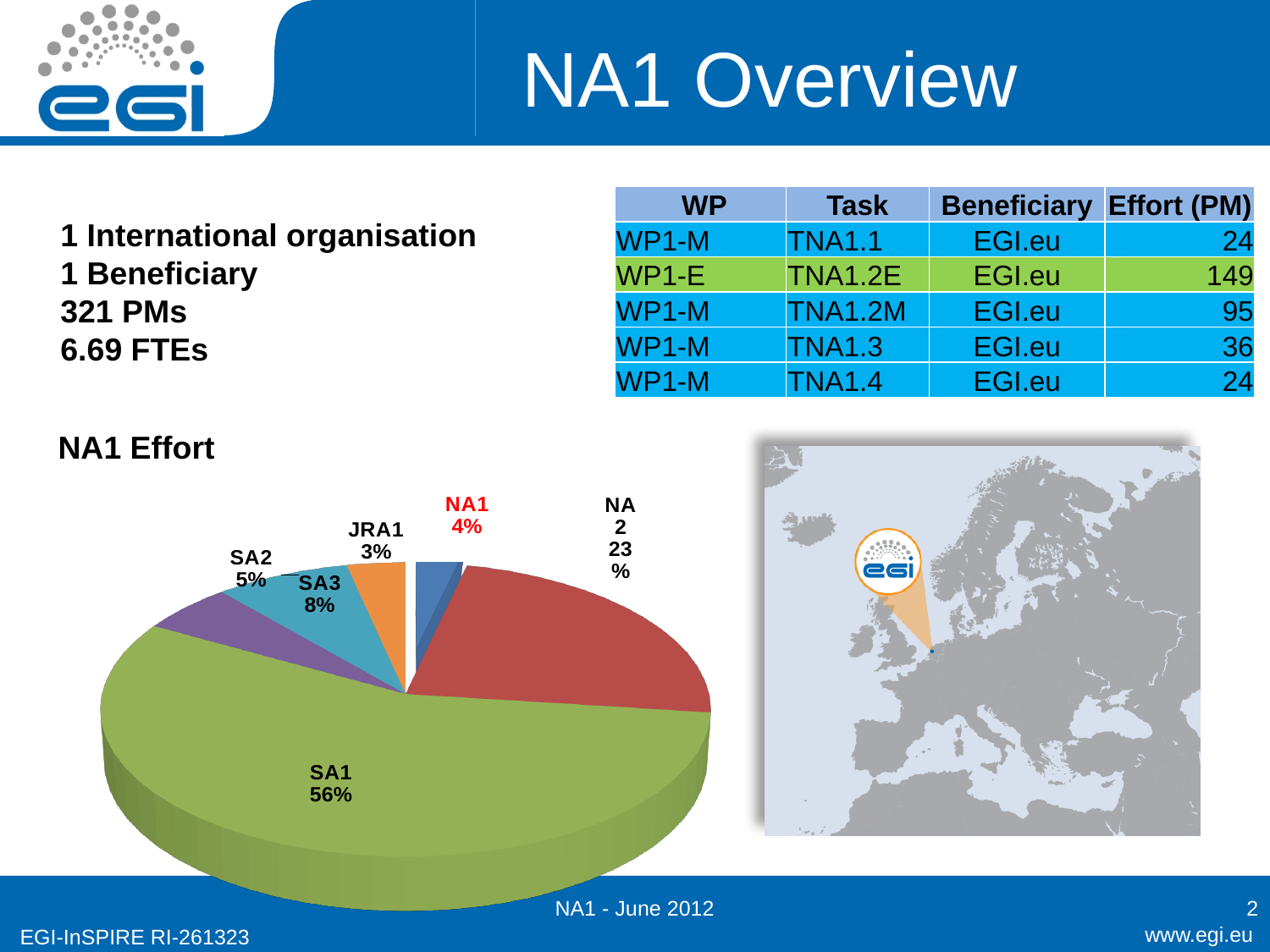
In the NA1 Effort pie chart, what share does JRA1 have? 3% In the NA1 Effort pie chart, which slice label is printed in red? NA1 Which slice is the largest in the NA1 Effort pie chart? SA1 In the NA1 Effort pie chart, what is the difference in percentage points between SA1 and NA2? 33 What kind of chart is shown under the heading "NA1 Effort"? pie chart In the NA1 Effort pie chart, what share does SA3 have? 8% In the NA1 Effort pie chart, which is larger, SA3 or SA2? SA3 How many slices does the NA1 Effort pie chart have? 6 In the NA1 Effort pie chart, what share does NA2 have? 23% In the NA1 Effort pie chart, what share does SA1 have? 56% Which slice is the smallest in the NA1 Effort pie chart? JRA1 In the NA1 Effort pie chart, what share does NA1 have? 4%